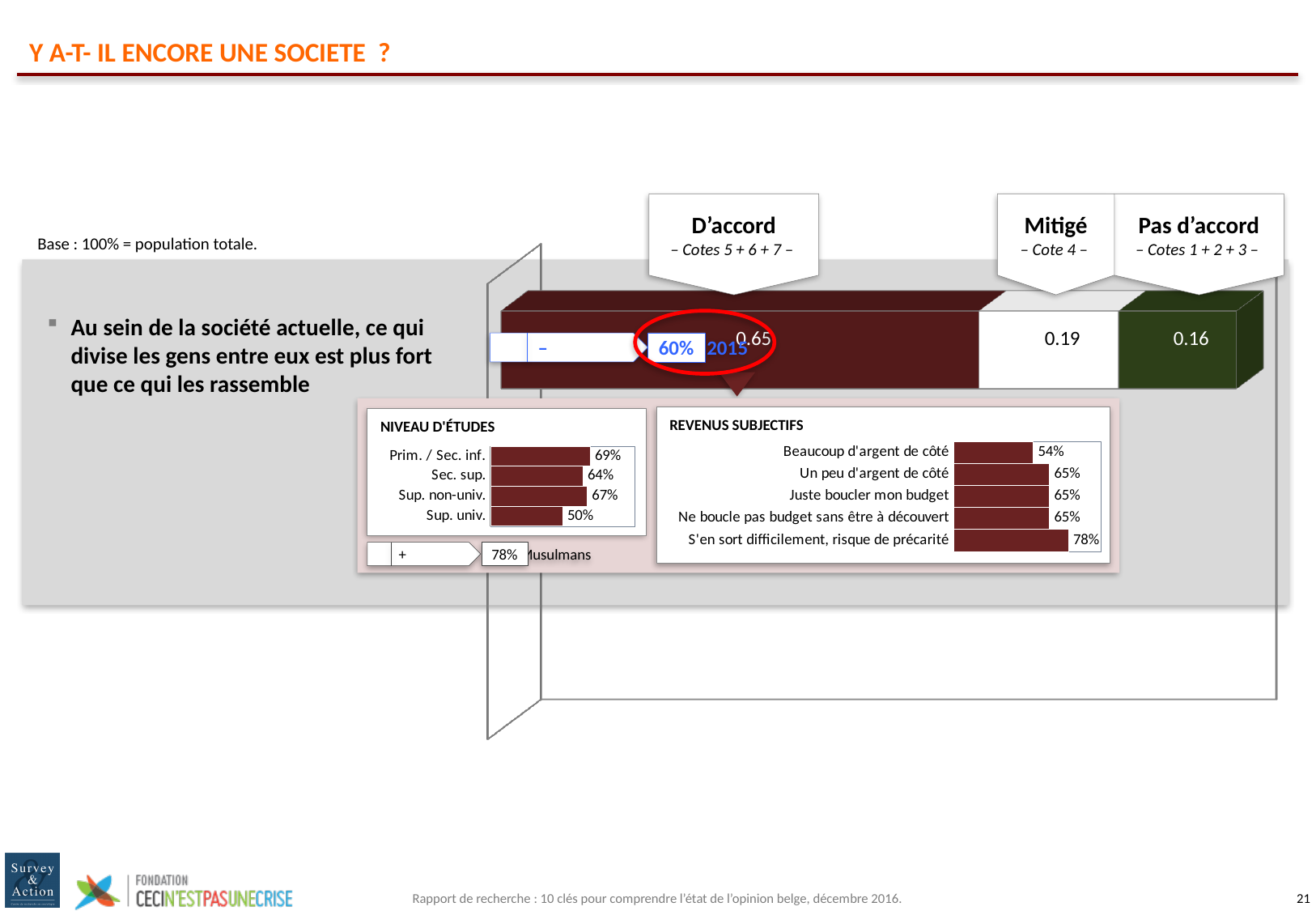
In the 'NIVEAU D'ÉTUDES' chart, which category has the highest value? Prim. / Sec. inf. How many categories are shown in the 'NIVEAU D'ÉTUDES' chart? 4 What kind of chart is the 'REVENUS SUBJECTIFS' chart? Bar chart How many categories are shown in the 'REVENUS SUBJECTIFS' chart? 5 In the main stacked bar, what is the value for 'Mitigé'? 0.19 In the main stacked bar, what is the value for 'Pas d'accord'? 0.16 In the 'REVENUS SUBJECTIFS' chart, which category has the lowest value? Beaucoup d'argent de côté In the 'NIVEAU D'ÉTUDES' chart, what is the difference between 'Prim. / Sec. inf.' and 'Sup. univ.'? 19 percentage points In the main stacked bar, which segment is the largest? D'accord In the 'NIVEAU D'ÉTUDES' chart, what is the value for 'Sup. univ.'? 50% In the main stacked bar, what is the value for 'D'accord'? 0.65 In the 'REVENUS SUBJECTIFS' chart, what is the value for 'S'en sort difficilement, risque de précarité'? 78%